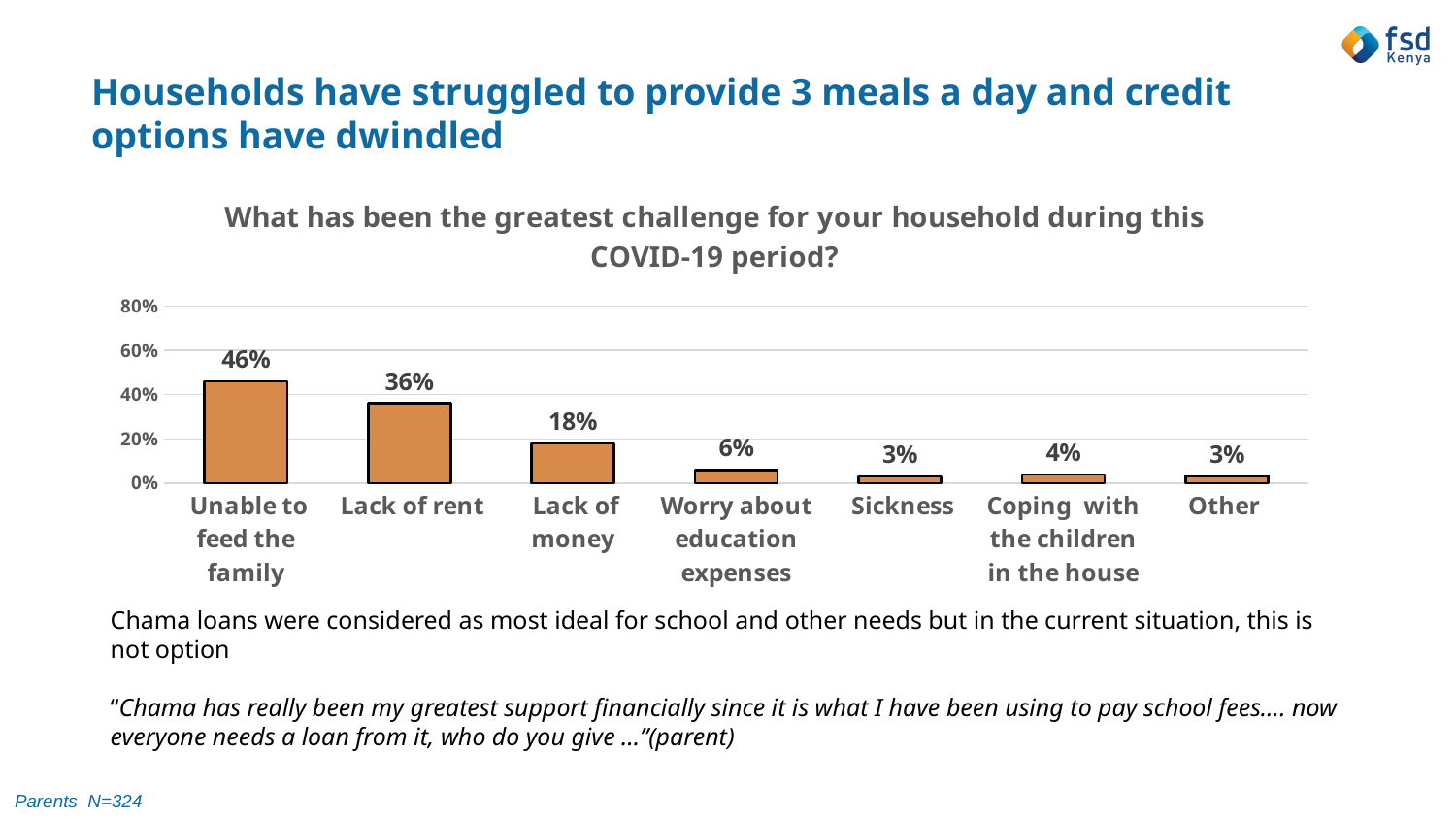
What kind of chart is shown on the slide? Bar chart How many categories are shown in the chart? 7 What is the value for Coping with the children in the house? 4% What percentage cited Worry about education expenses as the greatest challenge? 6% Which is larger, Worry about education expenses or Coping with the children in the house? Worry about education expenses What is the value for Lack of rent? 36% Is the value for Lack of money greater or less than 20%? less Which category has the highest value? Unable to feed the family What is the title of the chart? What has been the greatest challenge for your household during this COVID-19 period? What is the difference between Lack of rent and Lack of money? 18% What is the difference between Unable to feed the family and Lack of rent? 10% What percentage of households said they were unable to feed the family? 46%